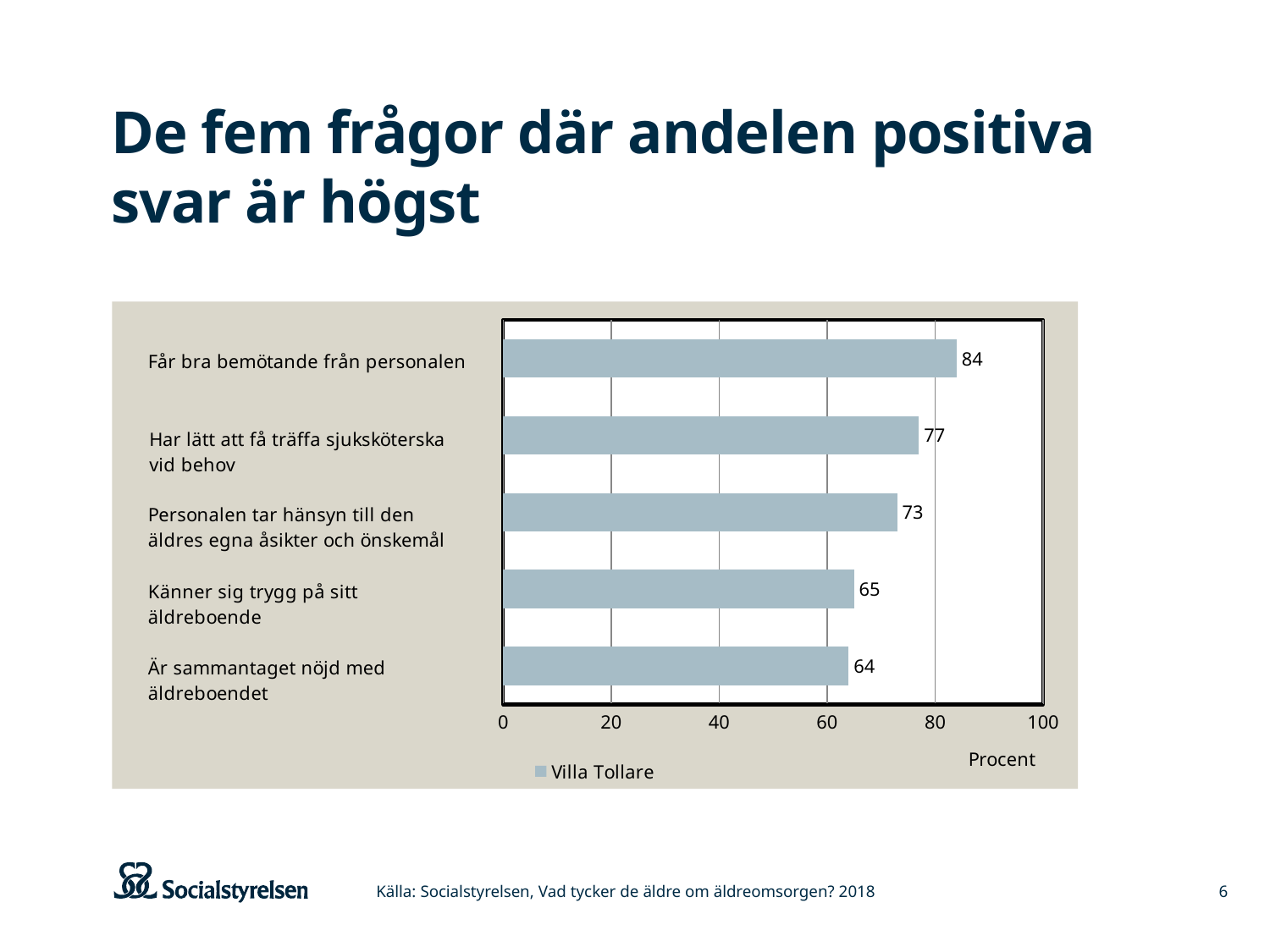
What is the name of the series shown in the legend? Villa Tollare Which category has the lowest value? Är sammantaget nöjd med äldreboendet Which is larger: the value for "Har lätt att få träffa sjuksköterska vid behov" or for "Känner sig trygg på sitt äldreboende"? Har lätt att få träffa sjuksköterska vid behov What is the value for "Får bra bemötande från personalen"? 84 What is the value for "Har lätt att få träffa sjuksköterska vid behov"? 77 Is the value for "Personalen tar hänsyn till den äldres egna åsikter och önskemål" greater or less than 80? less What is the difference between the values for "Får bra bemötande från personalen" and "Personalen tar hänsyn till den äldres egna åsikter och önskemål"? 11 What is the value for "Är sammantaget nöjd med äldreboendet"? 64 How many series does the legend list? 1 How many categories are shown in the chart? 5 What kind of chart is shown on the slide? bar chart Which category has the highest value? Får bra bemötande från personalen